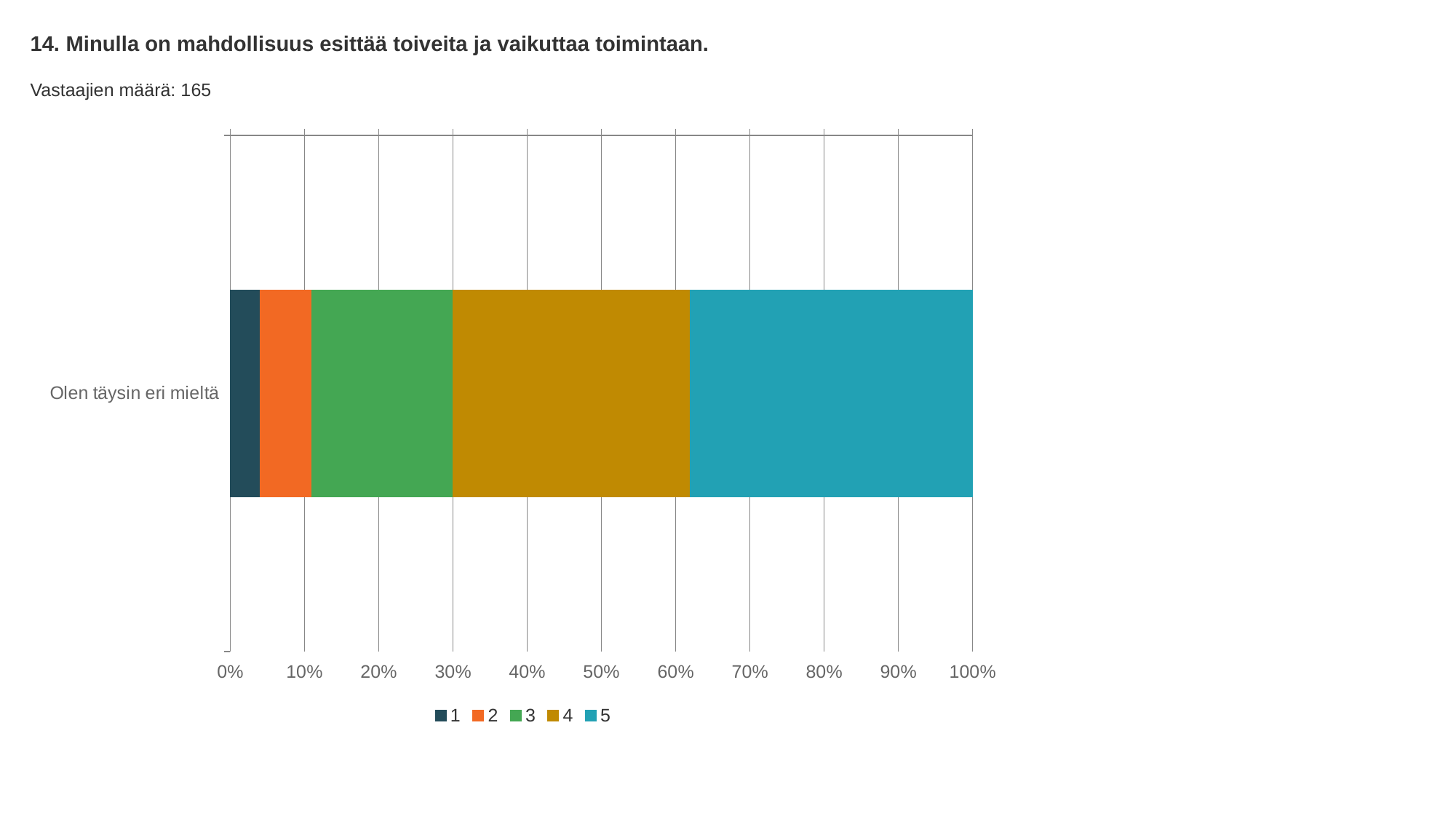
What is the label of the single category on the y axis? Olen täysin eri mieltä Is the share for series 1 greater or less than 10%? less How many series does the legend list? 5 Which segment is larger, series 3 or series 2? 3 What is the title of the chart? 14. Minulla on mahdollisuus esittää toiveita ja vaikuttaa toimintaan. Which series has the smallest segment in the bar? 1 Is the share for series 3 greater or less than 10%? greater What kind of chart is shown on the slide? Stacked bar chart Which series has the largest segment in the bar? 5 Which segment is larger, series 4 or series 3? 4 How many categories are plotted on the y axis? 1 Is the share for series 5 greater or less than 30%? greater